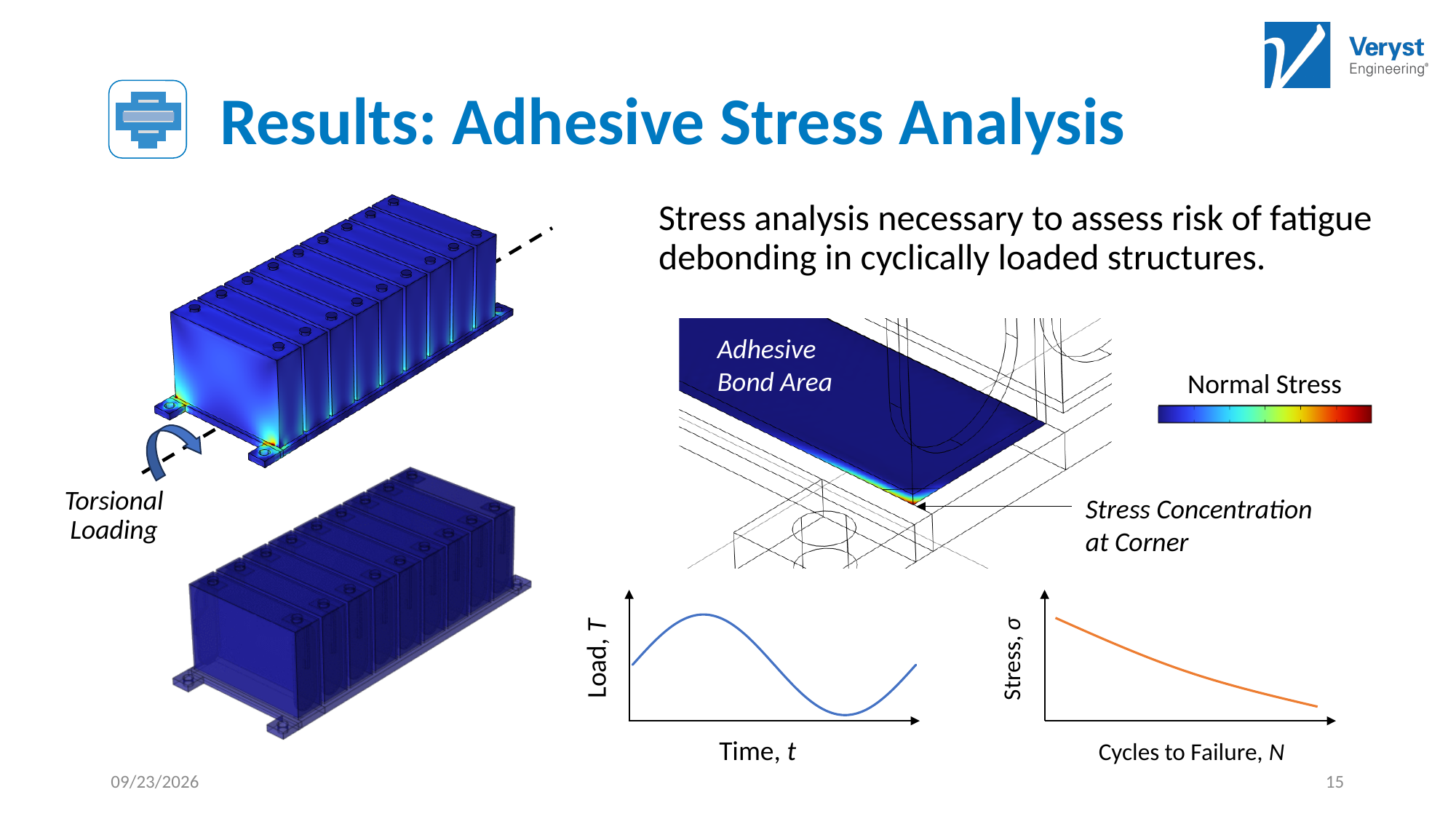
In the bottom-right chart, does Stress, σ rise or fall as Cycles to Failure, N increases? fall In the bottom-left chart, does the Load, T curve follow a steady rise, a steady fall, or an oscillating (wave-like) pattern over Time, t? oscillating What kind of chart is the bottom-right chart with axes Stress, σ and Cycles to Failure, N? line chart In the bottom-left chart, what is the label of the horizontal axis? Time, t In the bottom-right chart, how many lines are plotted? 1 In the bottom-left chart, how many lines are plotted? 1 What kind of chart is the bottom-left chart with axes Load, T and Time, t? line chart In the bottom-right chart, what is the label of the vertical axis? Stress, σ How many line charts are shown at the bottom of the slide? 2